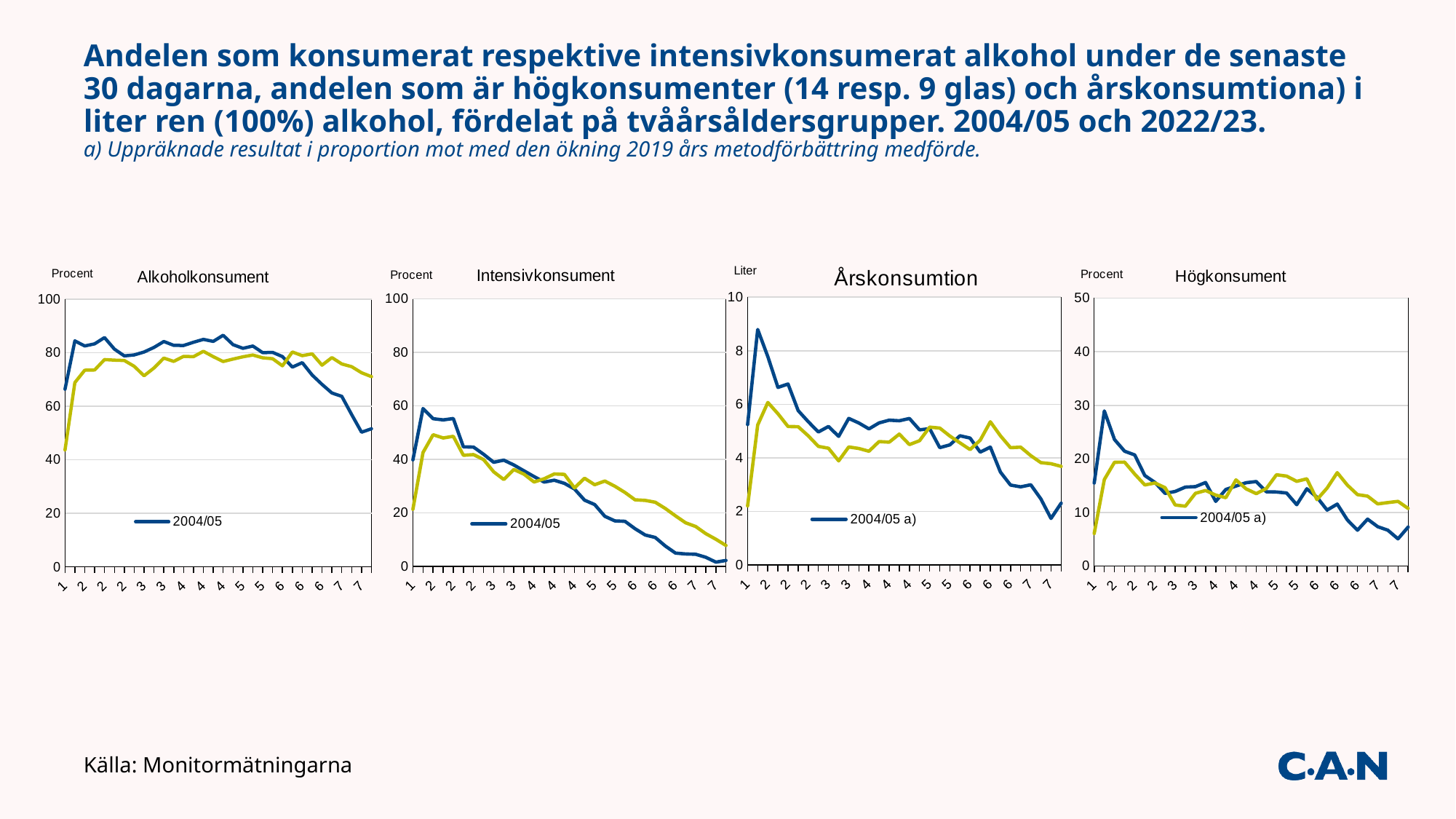
In the Högkonsument chart, is the peak value of the 2004/05 a) line greater or less than 20? greater In the Årskonsumtion chart, is the peak value of the 2004/05 a) line greater or less than 8? greater How many charts are shown on the slide? 4 In the Alkoholkonsument chart, does the 2004/05 line rise or fall over the last few age groups on the x axis? fall What unit is shown on the y axis of the Årskonsumtion chart? Liter What is the source given at the bottom of the slide? Monitormätningarna In the Alkoholkonsument chart, is the first value of the 2004/05 line greater or less than 80? less What is the highest value shown on the y axis of the Högkonsument chart? 50 In the Intensivkonsument chart, do the values of the 2004/05 line generally rise or fall after the early peak as you move along the x axis? fall What kind of chart is the Alkoholkonsument chart? Line chart